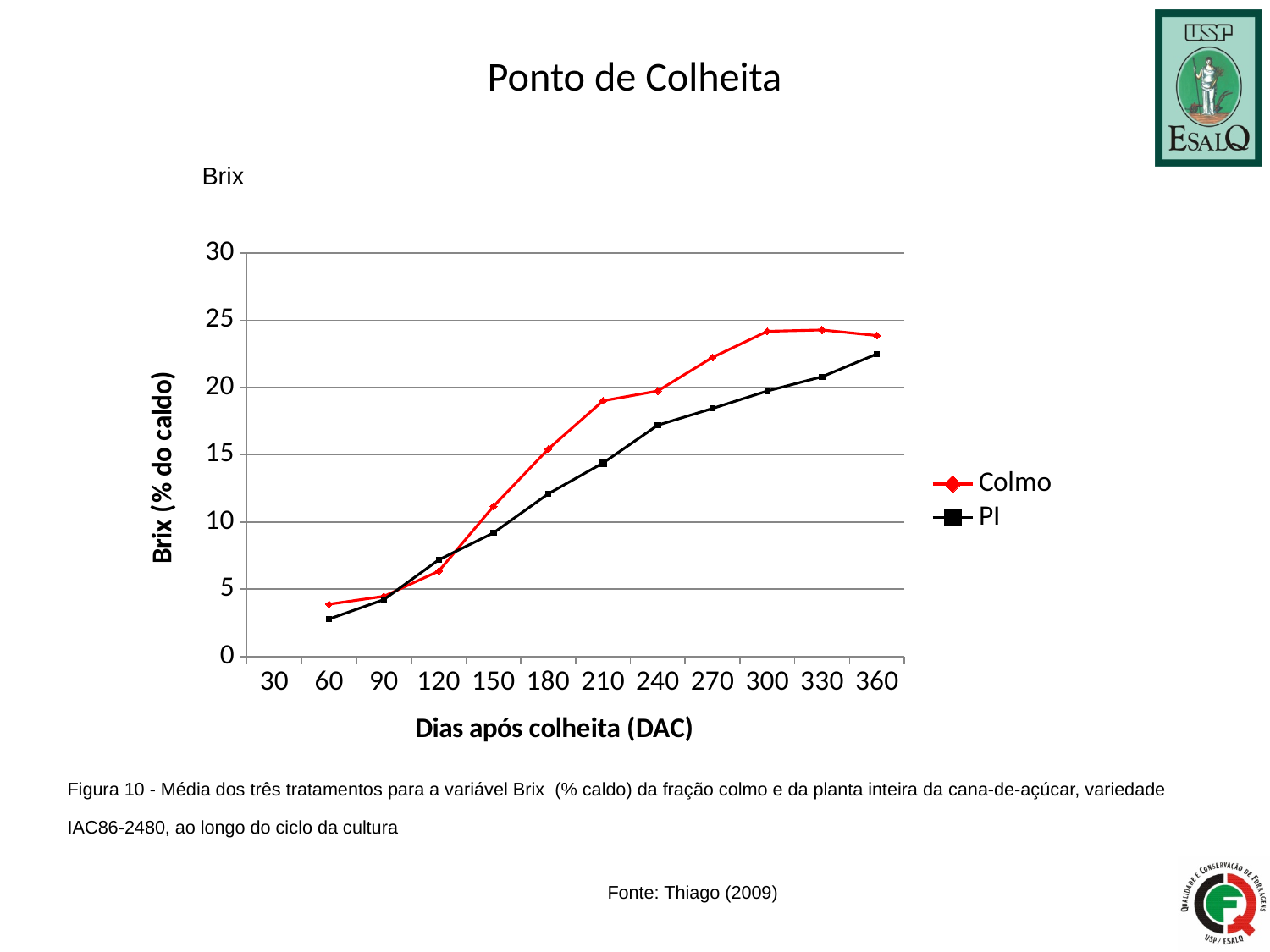
What kind of chart is shown on the slide? line chart How many series does the legend list? 2 At 210 DAC, which series has the higher Brix value, Colmo or PI? Colmo What is the label of the x axis? Dias após colheita (DAC) Do the Brix values for Colmo generally rise or fall from 60 to 300 DAC? rise Is the Brix value for Colmo at 300 DAC greater or less than 20? greater Is the Brix value for PI at 180 DAC greater or less than 15? less Is the Brix value for PI at 360 DAC greater or less than 20? greater Do the Brix values for PI rise or fall along the x axis from 60 to 360 DAC? rise What are the names of the two series in the legend? Colmo and PI At 120 DAC, which series has the higher Brix value, Colmo or PI? PI